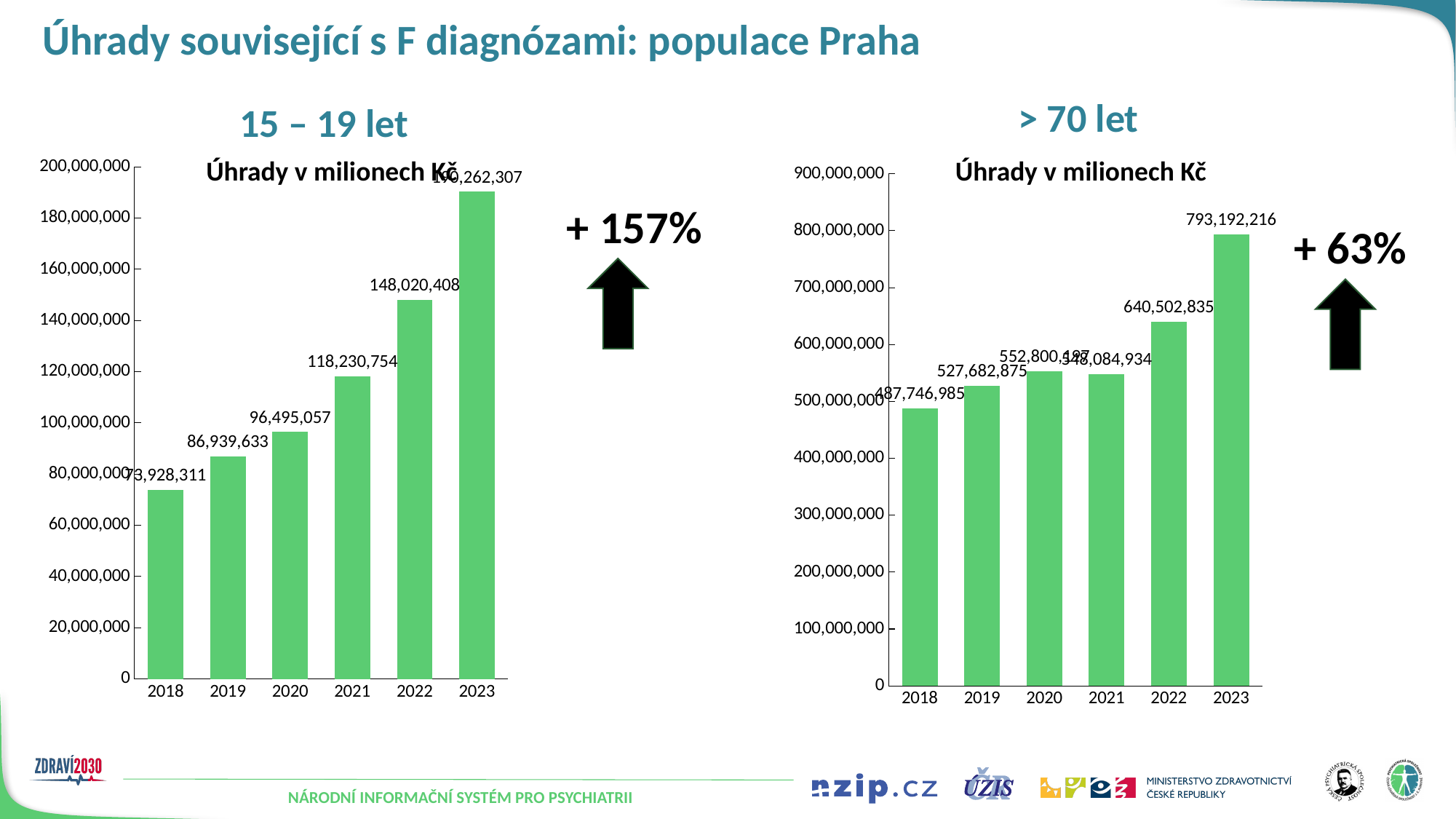
What type of chart is the 15 – 19 let chart? bar chart In the > 70 let chart, what is the value for 2019? 527,682,875 In the > 70 let chart, what is the value for 2023? 793,192,216 In the > 70 let chart, what is the difference between the values for 2023 and 2022? 152,689,381 In the 15 – 19 let chart, what is the value for 2022? 148,020,408 In the 15 – 19 let chart, what is the difference between the values for 2022 and 2021? 29,789,654 In the > 70 let chart, is the value for 2022 greater or less than 600,000,000? greater In the 15 – 19 let chart, is the value for 2023 greater or less than 180,000,000? greater How many years are shown on the x axis of the > 70 let chart? 6 In the 15 – 19 let chart, what is the value for 2018? 73,928,311 In the 15 – 19 let chart, which year has the highest value? 2023 In the > 70 let chart, which year has the lowest value? 2018